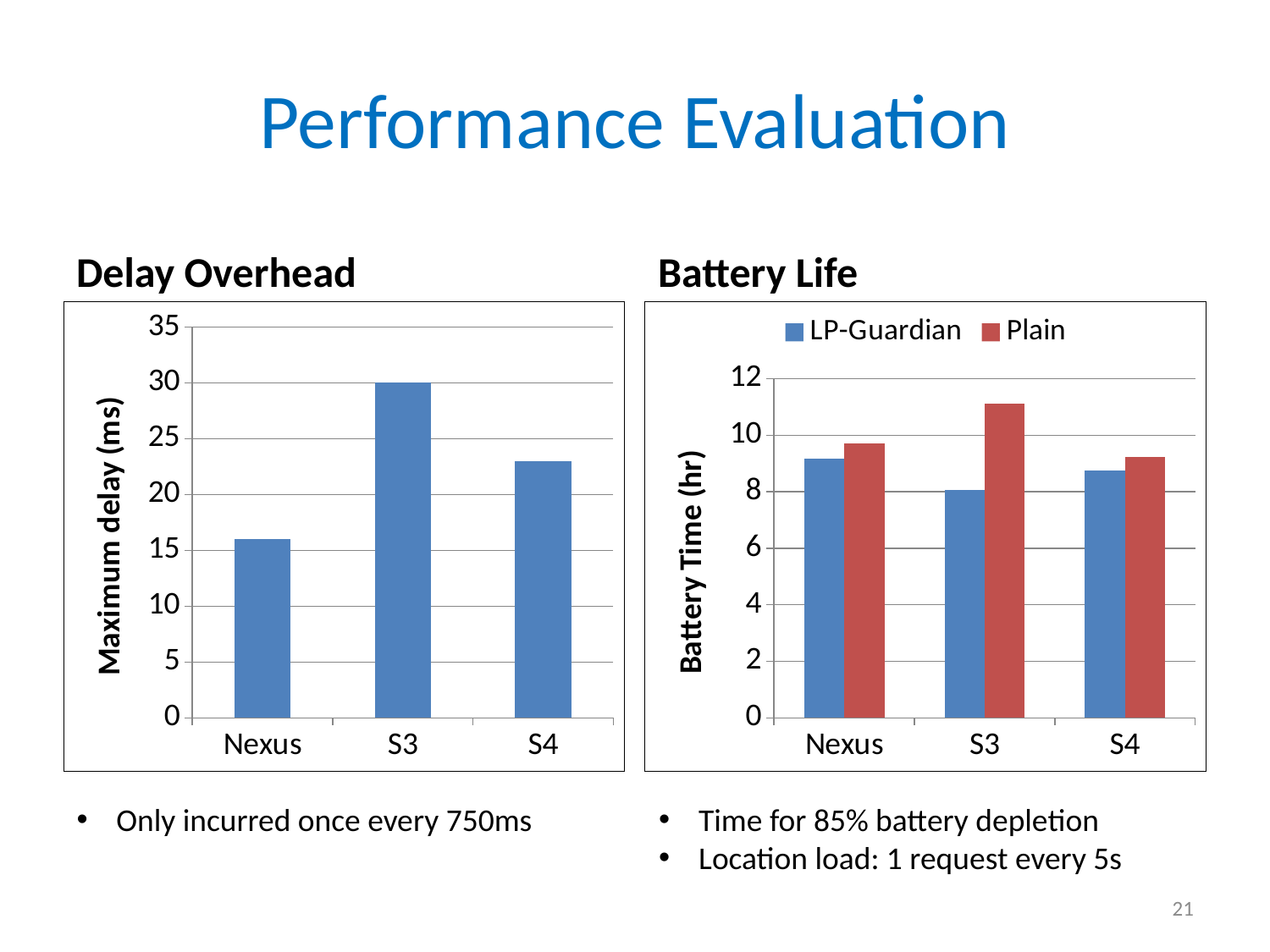
On the Battery Life chart, is the Plain value for S3 greater or less than 10? greater On the Delay Overhead chart, is the value for Nexus greater or less than 20? less On the Battery Life chart, for S3, which is larger: LP-Guardian or Plain? Plain On the Battery Life chart, how many series does the legend list? 2 On the Delay Overhead chart, how many devices are plotted? 3 On the Delay Overhead chart, which device has the lowest maximum delay? Nexus On the Battery Life chart, which device has the highest Plain battery time? S3 On the Battery Life chart, which device has the lowest LP-Guardian battery time? S3 On the Delay Overhead chart, what is the y-axis title? Maximum delay (ms) On the Delay Overhead chart, is the value for S4 greater or less than 20? greater On the Delay Overhead chart, which device has the highest maximum delay? S3 On the Delay Overhead chart, what kind of chart is shown? bar chart